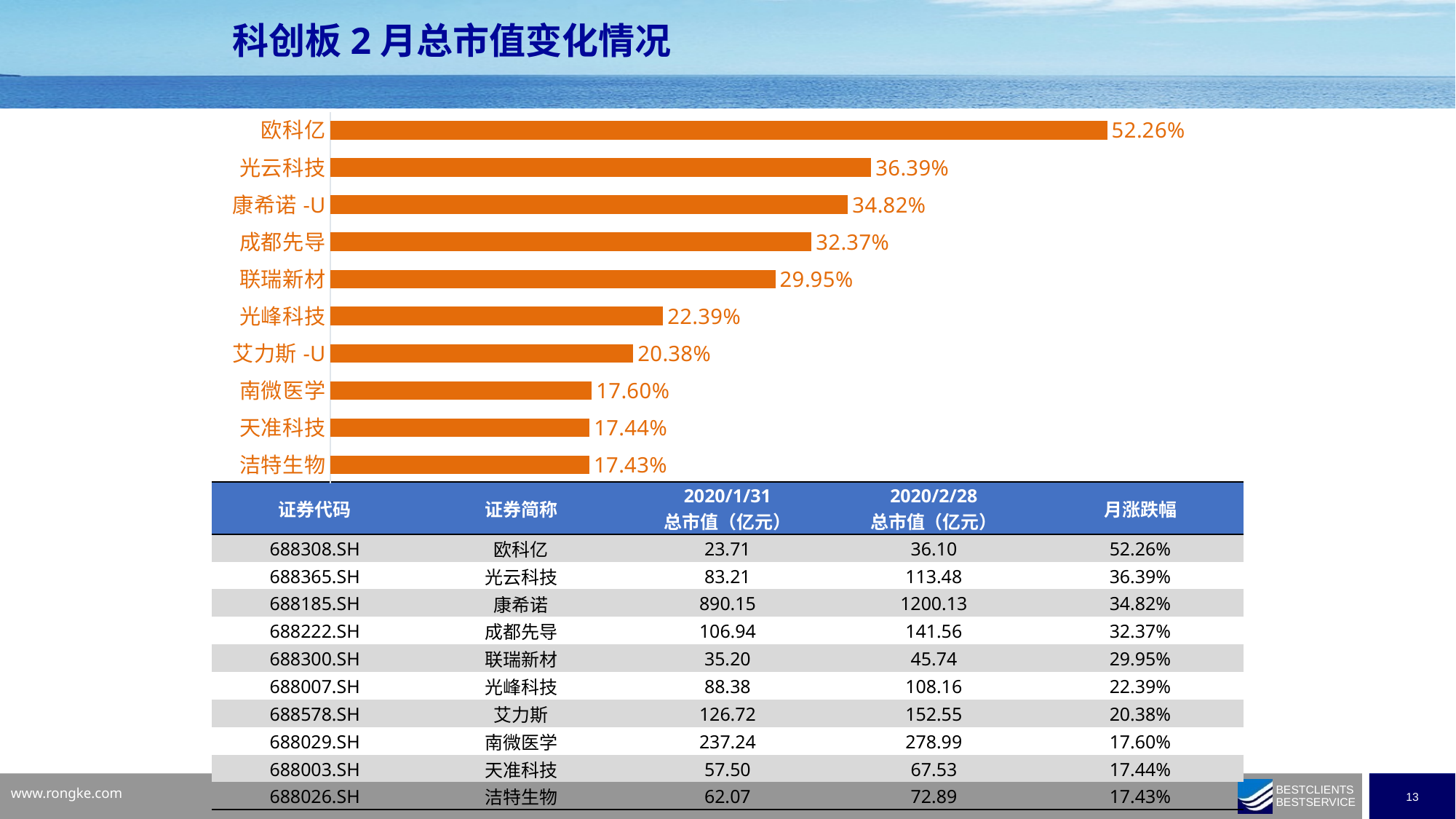
Which is larger, the value for 光峰科技 or the value for 艾力斯 -U? 光峰科技 What is the value for 欧科亿 in the bar chart? 52.26% What is the value for 联瑞新材 in the bar chart? 29.95% What is the value for 光峰科技 in the bar chart? 22.39% How many categories are shown in the bar chart? 10 What kind of chart is shown on the slide? bar chart What is the title of the slide containing the chart? 科创板 2 月总市值变化情况 Which category has the lowest value in the bar chart? 洁特生物 Which is larger, the value for 康希诺 -U or the value for 成都先导? 康希诺 -U What is the difference between the values for 欧科亿 and 光云科技? 15.87% What is the difference between the values for 成都先导 and 联瑞新材? 2.42% Which category has the highest value in the bar chart? 欧科亿